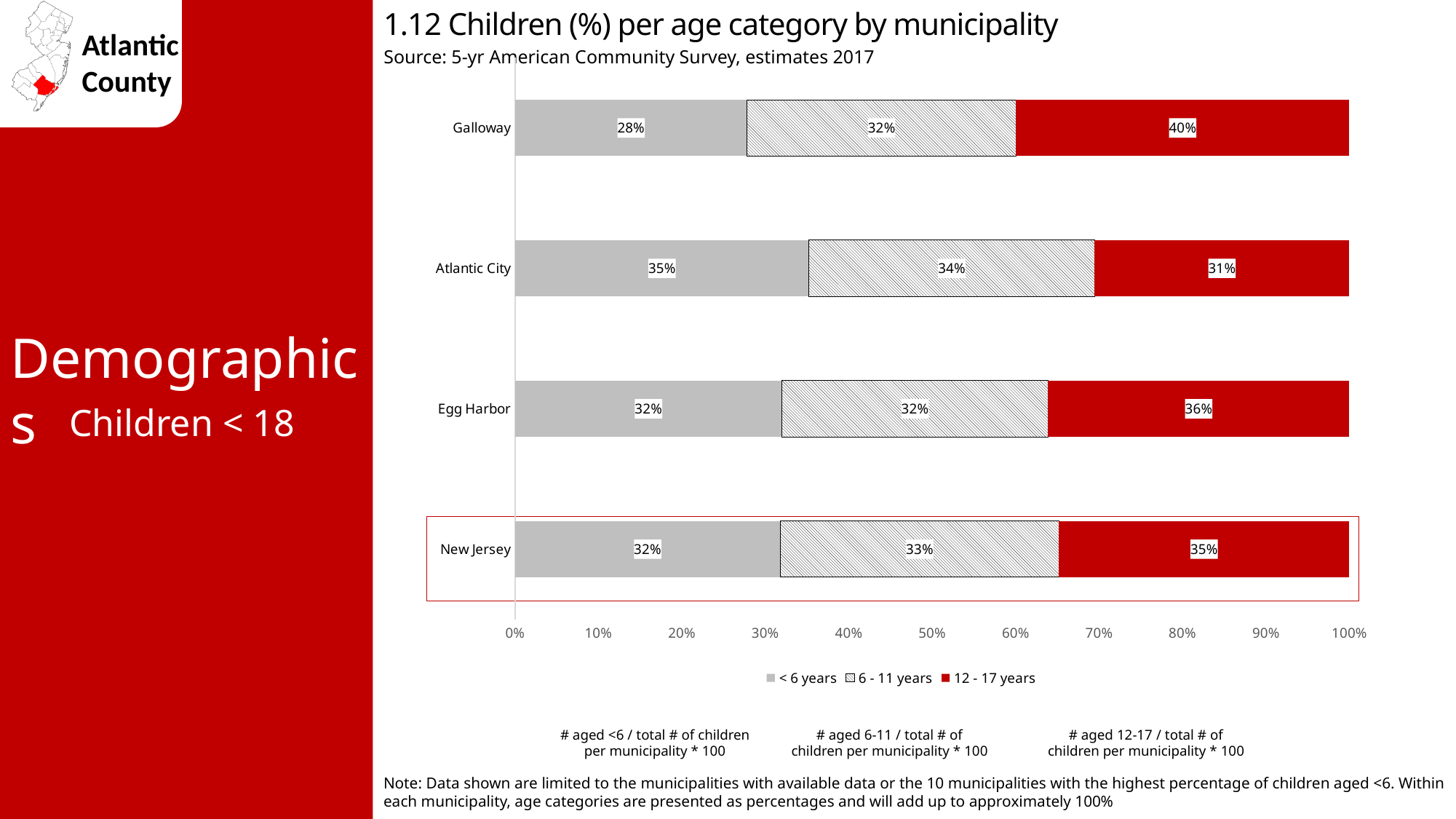
What percentage of children in New Jersey are aged 12 - 17 years? 35% Which series is shown in red in the chart? 12 - 17 years How many series does the legend list? 3 How many municipalities or regions are shown on the chart? 4 What kind of chart is shown on the slide? Stacked bar chart What percentage of children in Egg Harbor are aged 6 - 11 years? 32% Which municipality has the lowest percentage of children under 6 years? Galloway What percentage of children in Galloway are aged 12 - 17 years? 40% What percentage of children in Atlantic City are under 6 years old? 35% Which municipality has the highest percentage of children aged 12 - 17 years? Galloway What is the difference between the < 6 years percentage for Atlantic City and for Galloway? 7% Is the 12 - 17 years percentage larger for Egg Harbor or for Atlantic City? Egg Harbor